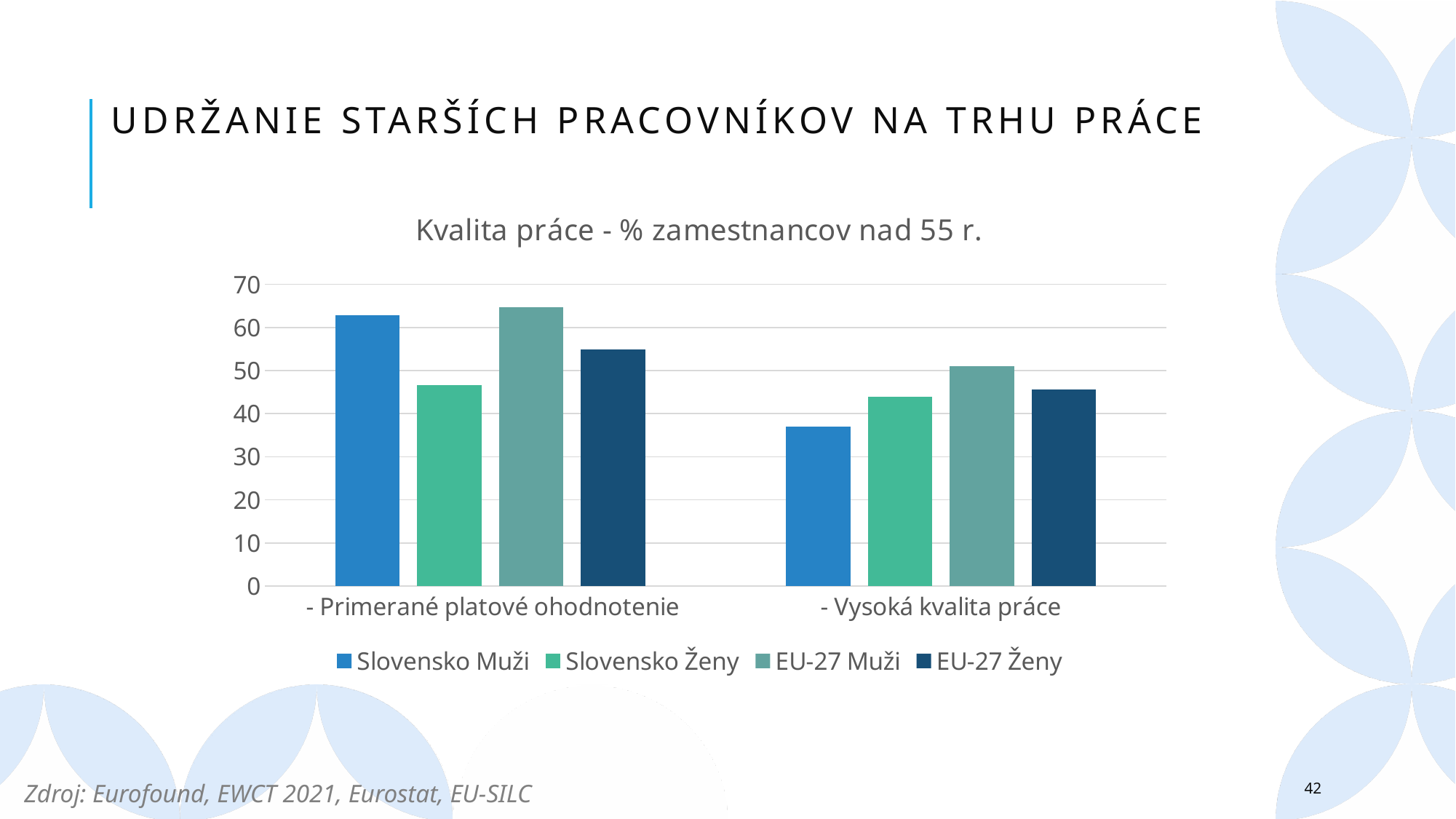
Is the value for Slovensko Muži in '- Primerané platové ohodnotenie' greater or less than 60? greater Which is larger for '- Vysoká kvalita práce': Slovensko Ženy or EU-27 Muži? EU-27 Muži Which series has the lowest value for '- Vysoká kvalita práce'? Slovensko Muži How many series does the legend list? 4 Does the value for Slovensko Muži rise or fall from '- Primerané platové ohodnotenie' to '- Vysoká kvalita práce'? fall How many categories are shown on the x axis? 2 Which series has the highest value for '- Vysoká kvalita práce'? EU-27 Muži Which series has the highest value for '- Primerané platové ohodnotenie'? EU-27 Muži Is the value for Slovensko Muži in '- Vysoká kvalita práce' greater or less than 40? less What kind of chart is shown on the slide? bar chart Which series has the lowest value for '- Primerané platové ohodnotenie'? Slovensko Ženy What is the title of the chart? Kvalita práce - % zamestnancov nad 55 r.